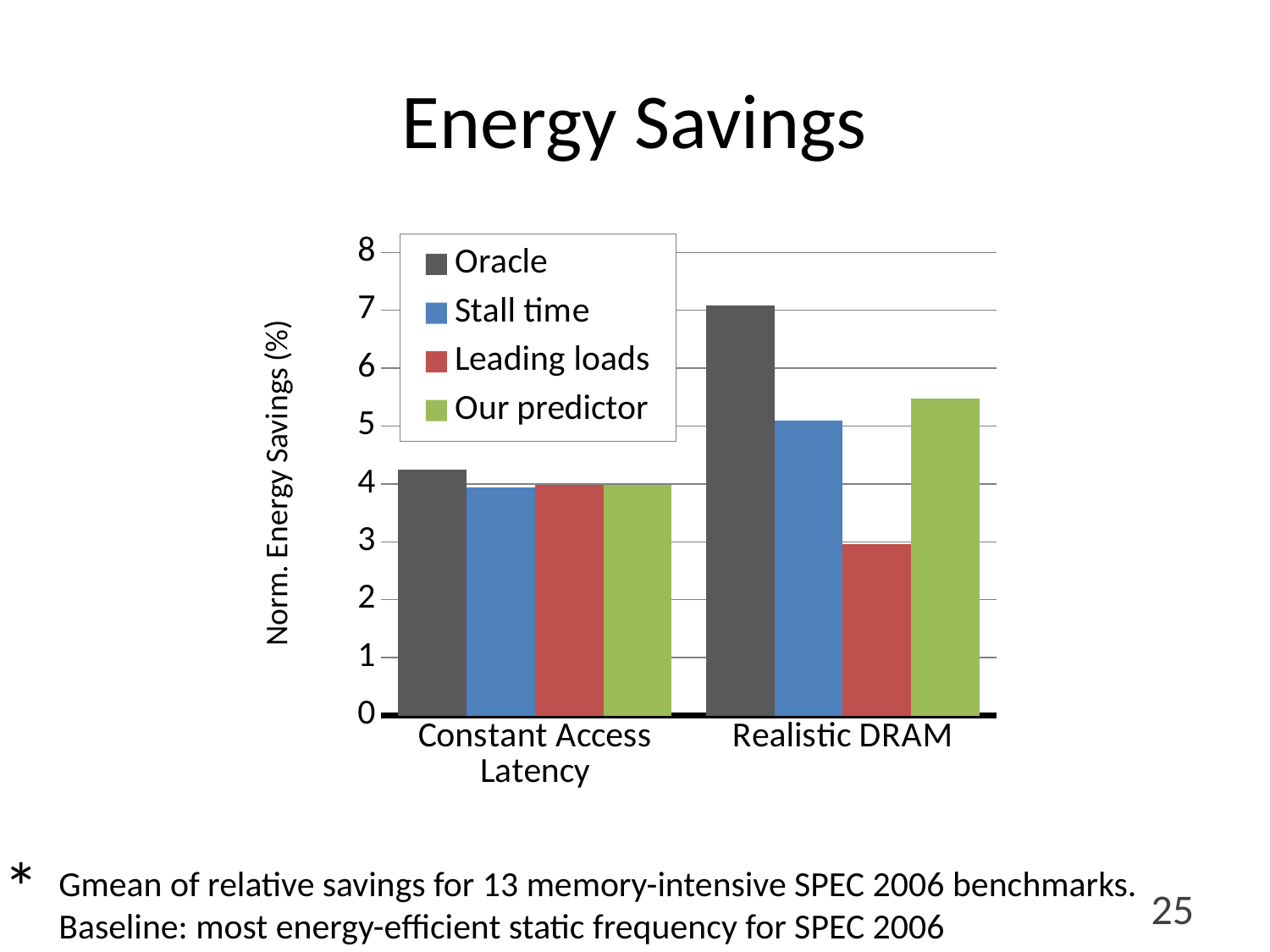
How many series does the legend list? 4 Which series has the highest value for Constant Access Latency? Oracle What is the label of the y axis? Norm. Energy Savings (%) Is the value for Our predictor under Realistic DRAM greater or less than 5? greater Which series has the lowest value for Realistic DRAM? Leading loads Is the value for Oracle under Realistic DRAM greater or less than 6? greater Is the value for Leading loads under Realistic DRAM greater or less than 4? less Which series has the highest value for Realistic DRAM? Oracle For Realistic DRAM, which is larger: Our predictor or Stall time? Our predictor What kind of chart is shown on the slide? bar chart Does the Oracle value rise or fall from Constant Access Latency to Realistic DRAM? rise How many categories are shown on the x axis? 2